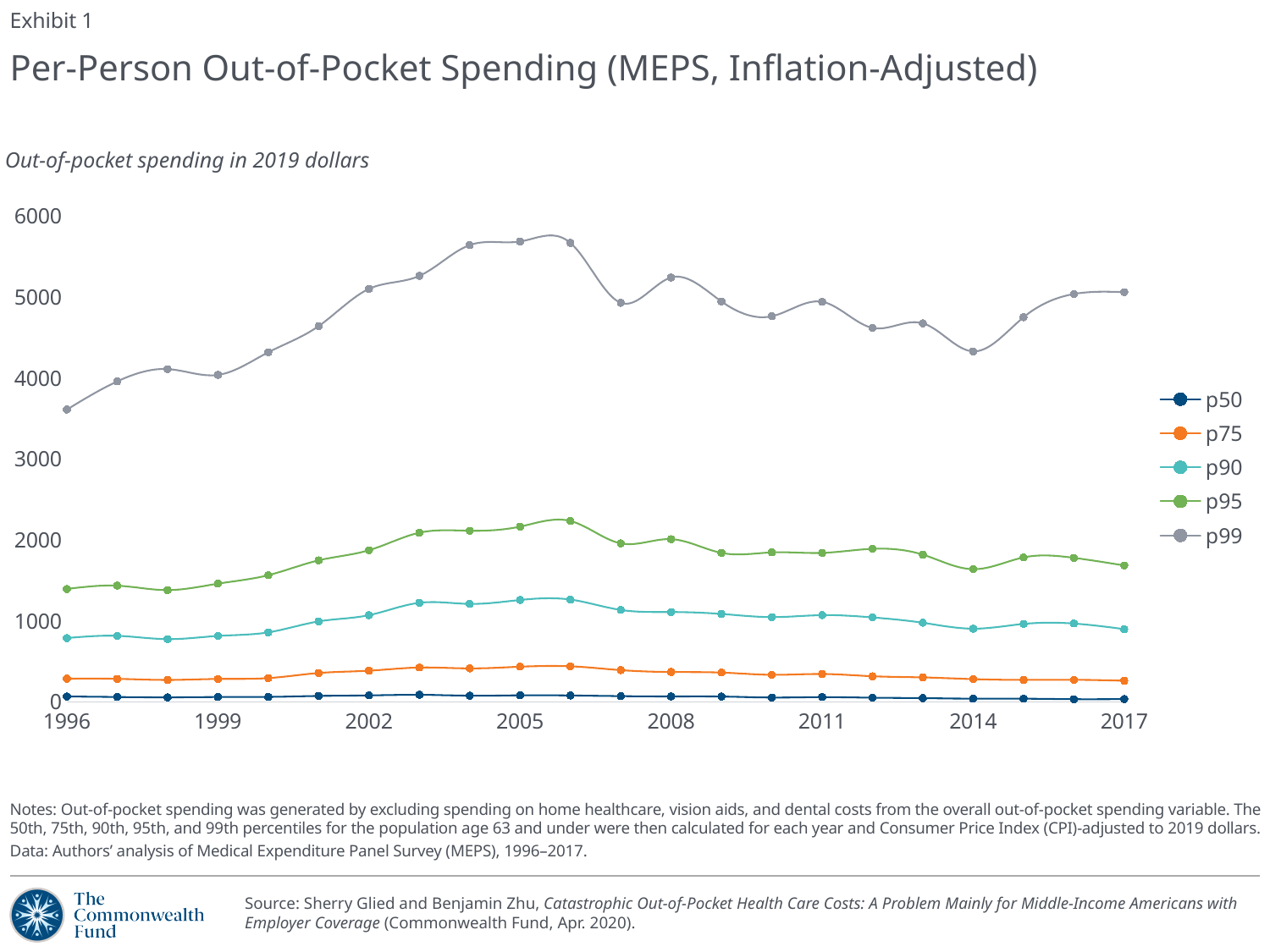
How many series does the legend list? 5 Is the value for p95 in 2006 greater or less than 2000? greater Which series has the lowest values throughout the chart? p50 Which is larger for p99: the value in 2005 or the value in 2014? 2005 Is the value for p99 in 2005 greater or less than 5000? greater Is the value for p90 in 2017 greater or less than 1000? less How many years are plotted along the x axis for each series? 22 What is the title of the chart? Per-Person Out-of-Pocket Spending (MEPS, Inflation-Adjusted) Which series has the highest values throughout the chart? p99 What kind of chart is shown on the slide? line chart Does the p99 series rise or fall between 1996 and 2005? rise